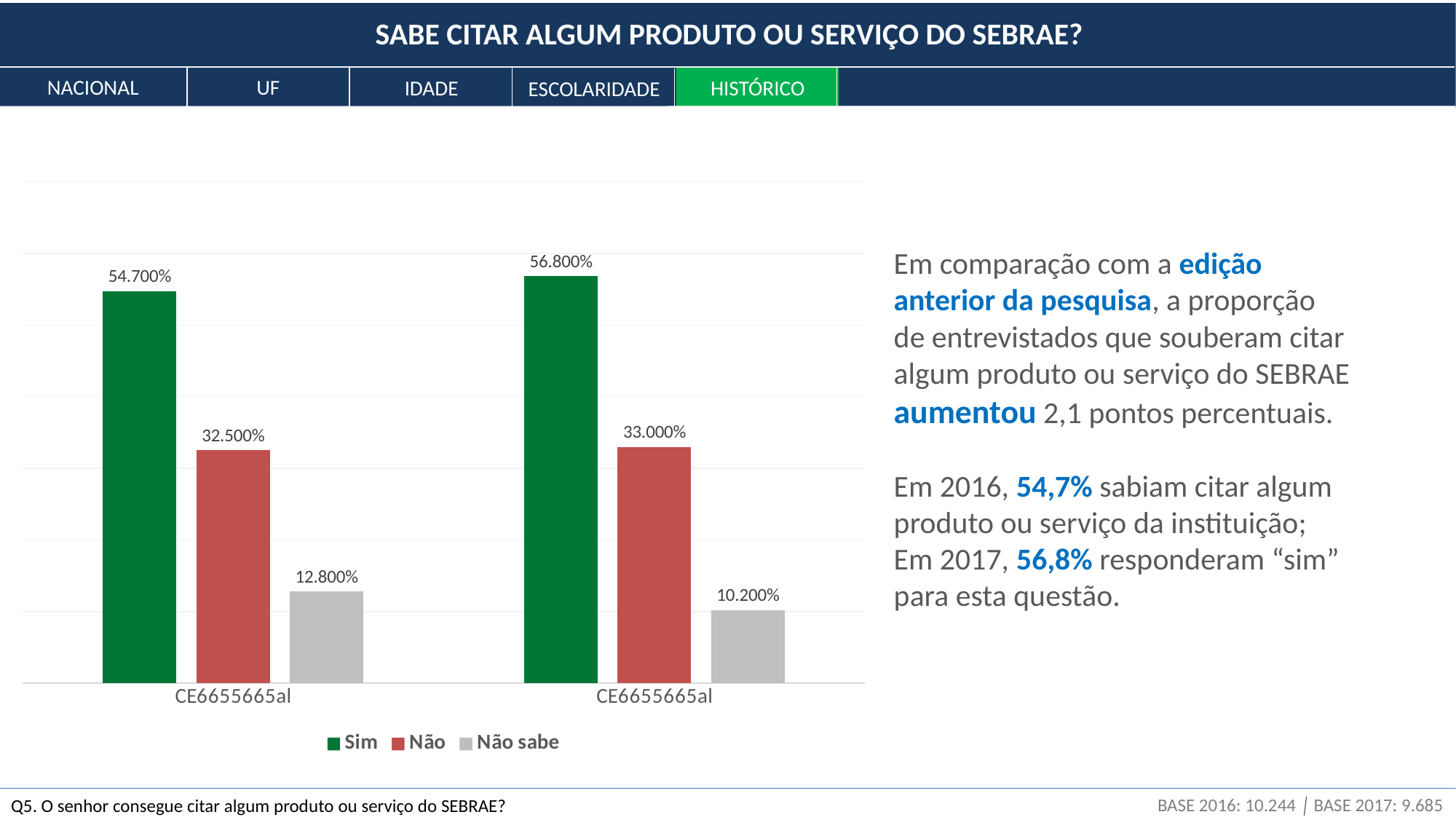
What is the difference between the Não sabe values of the left group and the right group? 2.600% How many series does the legend list? 3 Which is larger: the Não bar in the left group or the Não bar in the right group? Não bar in the right group Which series has the lowest value in the left group of the chart? Não sabe What is the value of the Sim bar in the left group of the chart? 54.700% What is the value of the Não sabe bar in the right group of the chart? 10.200% What is the value of the Sim bar in the right group of the chart? 56.800% What colour are the Sim bars in the chart? Green What is the value of the Não bar in the left group of the chart? 32.500% What kind of chart is shown on the slide? Bar chart Which series has the highest value in the right group of the chart? Sim What is the difference between the Sim values of the right group and the left group? 2.100%